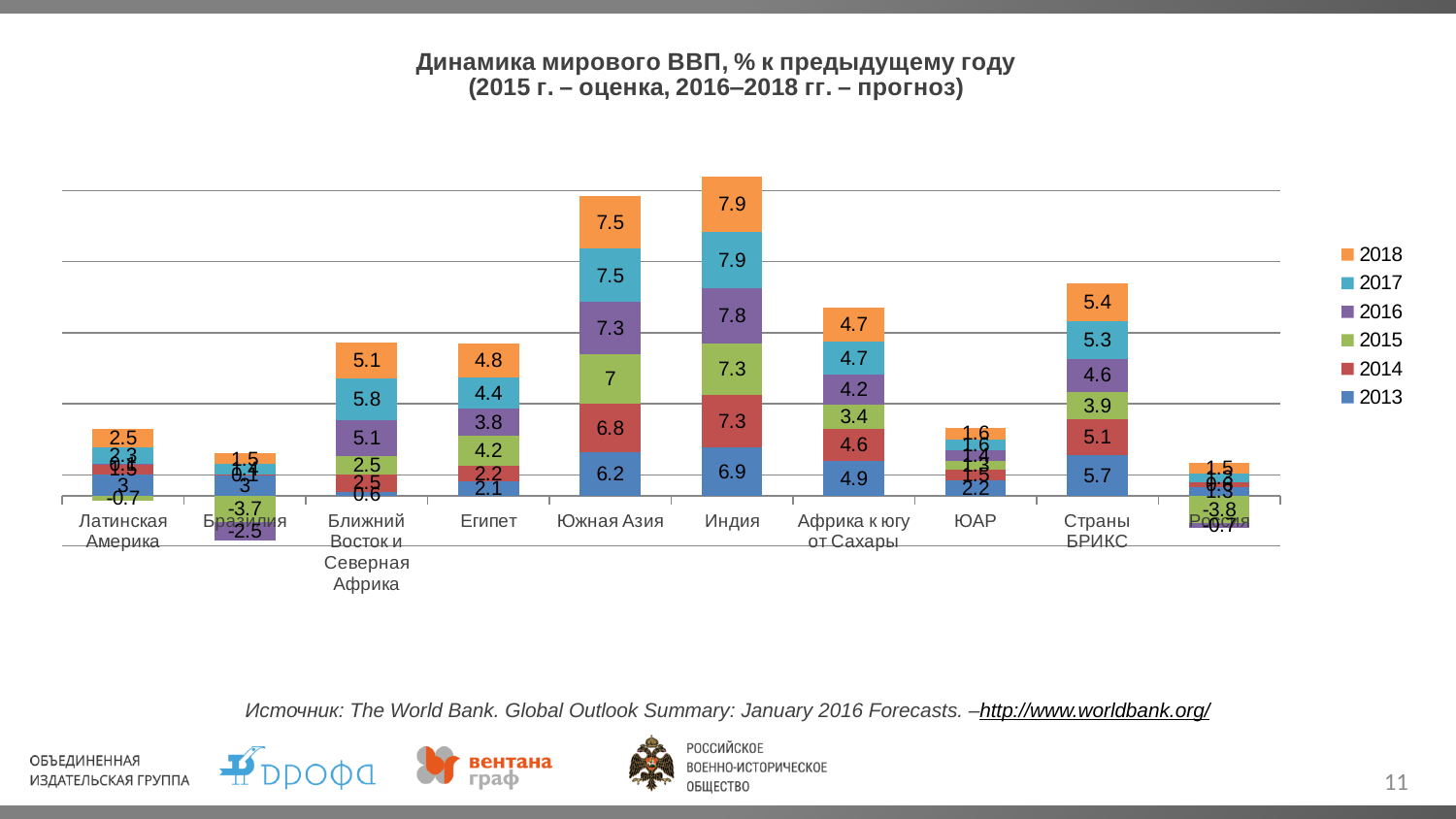
What is the 2013 value for Южная Азия? 6.2 Which category has the tallest stacked bar? Индия What is the 2017 value for Ближний Восток и Северная Африка? 5.8 What is the 2013 value for Страны БРИКС? 5.7 How many categories (regions/countries) are shown on the x axis? 10 Which is larger, the 2016 value for Африка к югу от Сахары or the 2016 value for Страны БРИКС? Страны БРИКС What is the 2018 value for Индия? 7.9 What is the 2015 value for Египет? 4.2 What kind of chart is shown on the slide? stacked bar chart Which series is shown in orange in the legend? 2018 How many series does the legend list? 6 What is the difference between the 2018 values for Индия and Южная Азия? 0.4